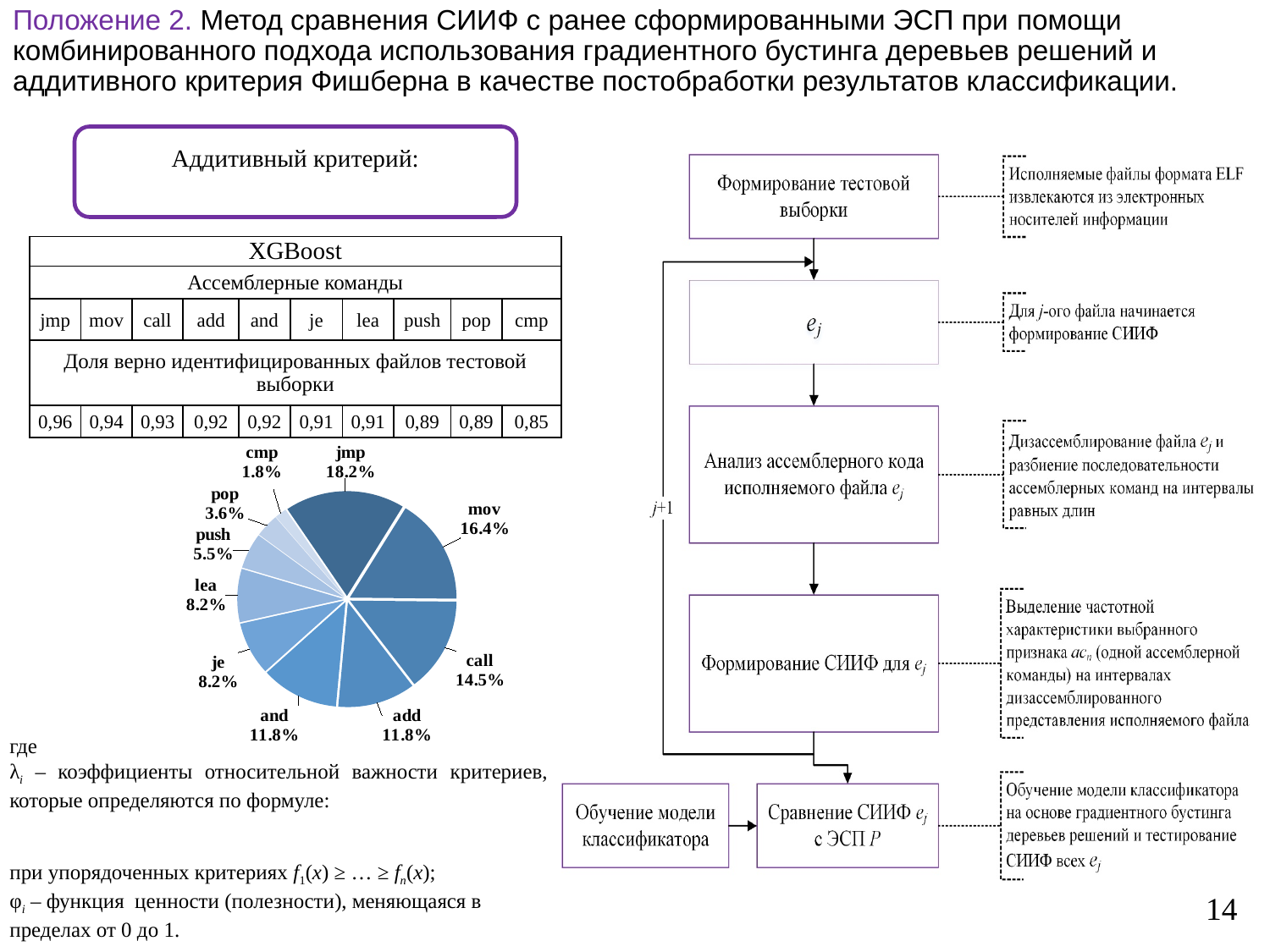
What share of the pie does the jmp slice have? 18.2% What kind of chart is shown on the slide? pie chart What is the difference between the call and cmp shares in the pie chart? 12.7% Which slice of the pie chart is the largest? jmp Which slice of the pie chart is the smallest? cmp What share of the pie does the mov slice have? 16.4% Which slice is larger in the pie chart, lea or pop? lea Which two slices in the pie chart both have a share of 11.8%? and, add What is the difference between the jmp and mov shares in the pie chart? 1.8% How many slices does the pie chart have? 10 What is the value shown for the call slice in the pie chart? 14.5% What is the value shown for the push slice in the pie chart? 5.5%